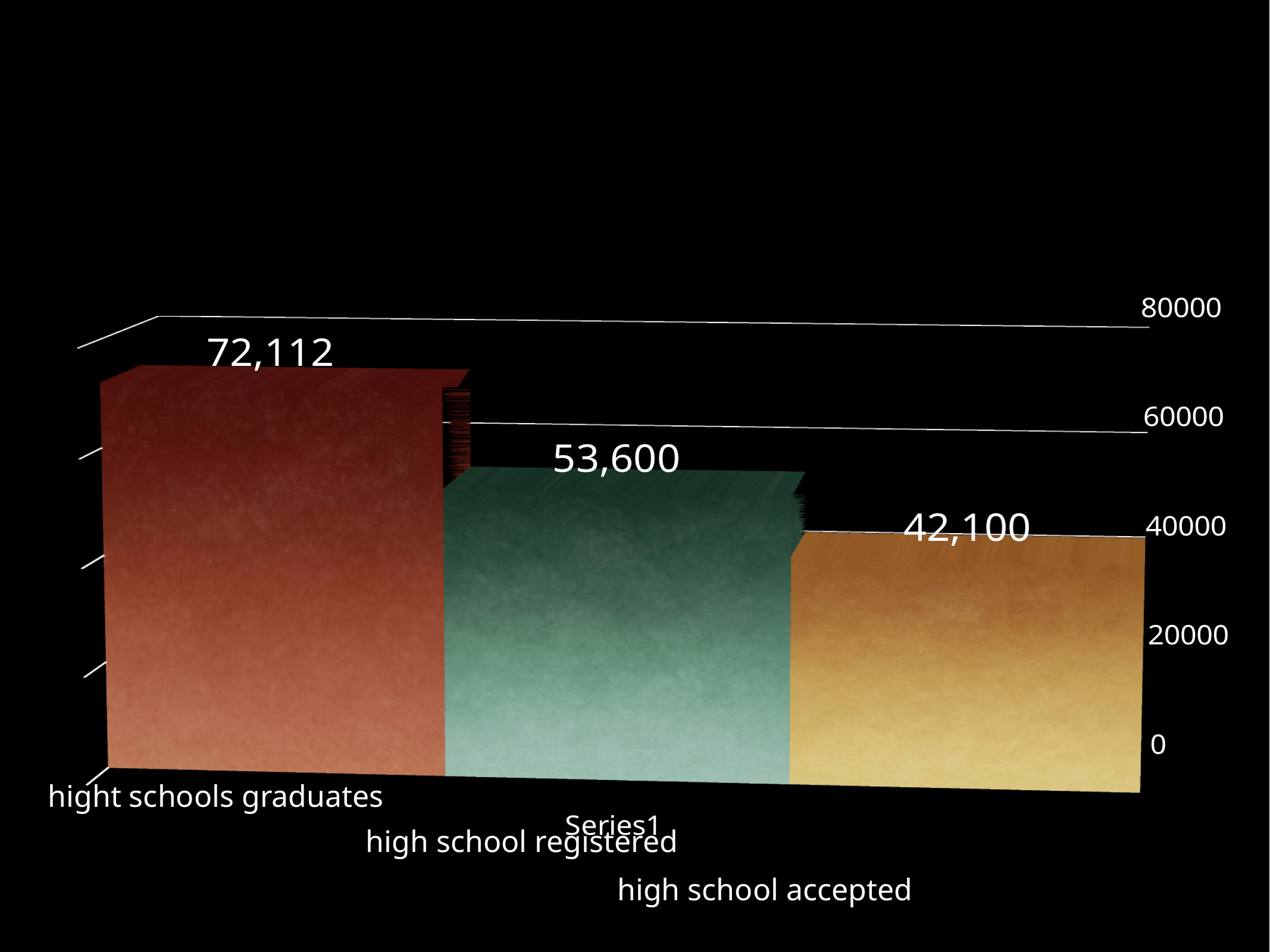
Which category has the highest value? hight schools graduates Is the value for high school accepted greater or less than 60000? less What is the value for high school registered? 53,600 How many categories are shown in the chart? 3 Do the values rise or fall from left to right across the categories? fall What is the difference between hight schools graduates and high school registered? 18,512 What is the difference between high school registered and high school accepted? 11,500 Which category has the lowest value? high school accepted Which is larger, high school registered or high school accepted? high school registered What kind of chart is shown on the slide? bar chart What is the value for high school accepted? 42,100 What is the value for hight schools graduates? 72,112